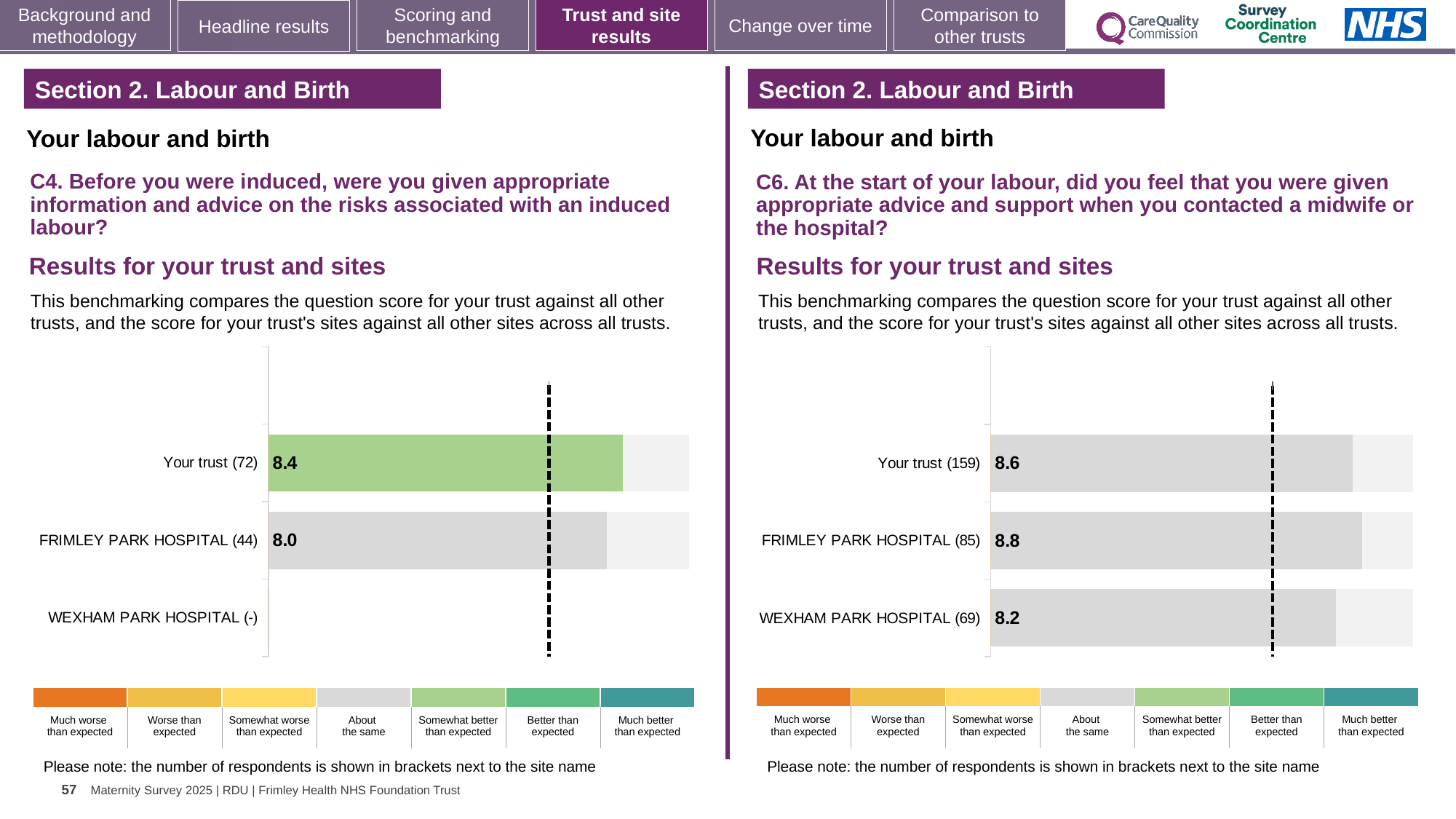
In the right chart (C6), what is the difference between the score for FRIMLEY PARK HOSPITAL and the score for WEXHAM PARK HOSPITAL? 0.6 In the right chart (C6), which site or trust has the lowest score? WEXHAM PARK HOSPITAL In the left chart (C4), what is the score for Your trust? 8.4 In the right chart (C6), what is the score for WEXHAM PARK HOSPITAL? 8.2 In the left chart (C4), which benchmark category does the colour of the Your trust bar correspond to? Somewhat better than expected In the right chart (C6), which site or trust has the highest score? FRIMLEY PARK HOSPITAL In the left chart (C4), what is the score for FRIMLEY PARK HOSPITAL? 8.0 In the right chart (C6), what is the score for FRIMLEY PARK HOSPITAL? 8.8 How many respondents are shown in brackets for Your trust in the right chart (C6)? 159 What kind of chart is used in the left chart (C4)? Bar chart In the right chart (C6), which is larger: the score for Your trust or the score for WEXHAM PARK HOSPITAL? Your trust In the left chart (C4), what is the difference between the score for Your trust and the score for FRIMLEY PARK HOSPITAL? 0.4